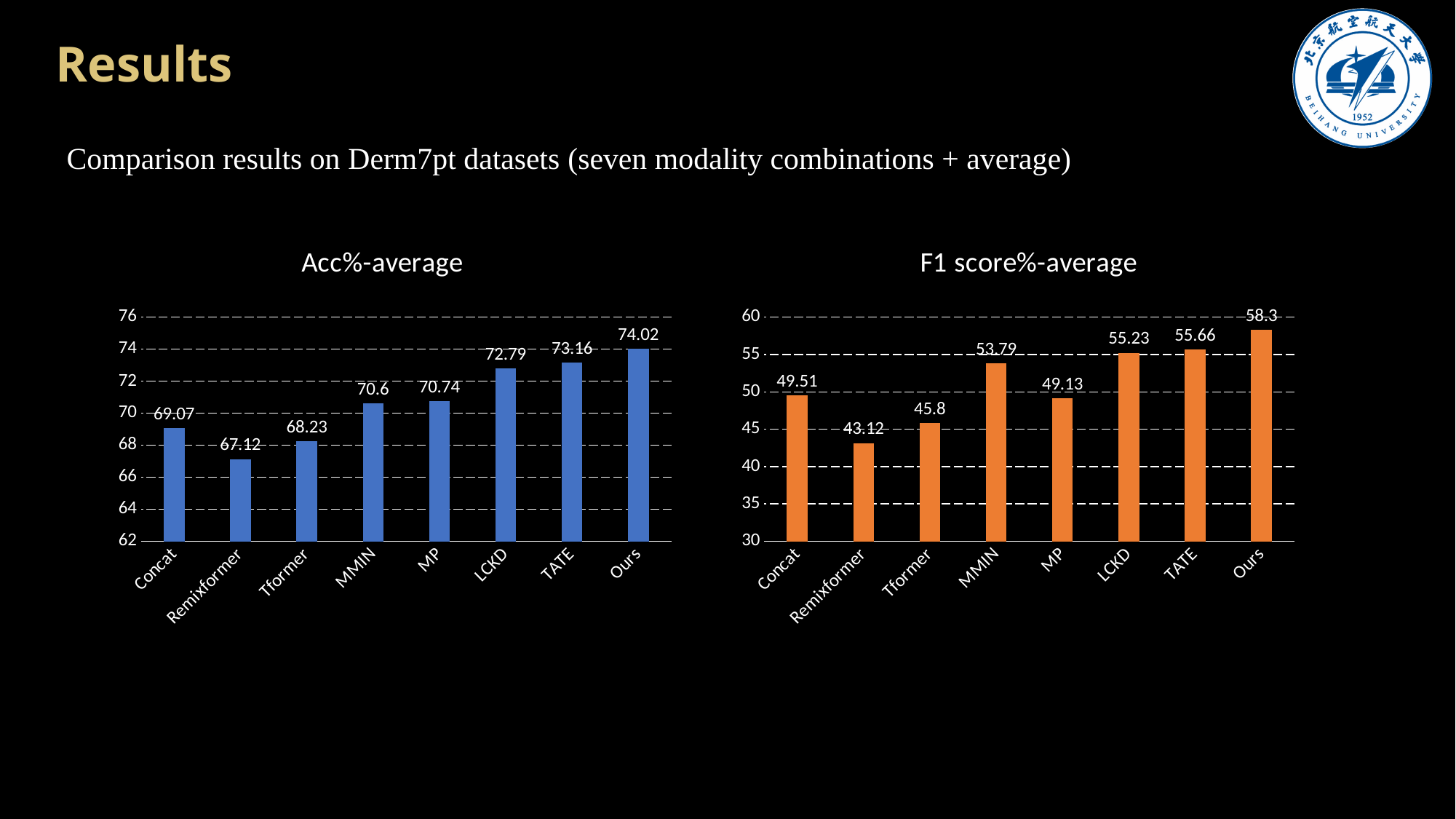
What colour are the bars in the F1 score%-average chart? orange What kind of chart is the F1 score%-average chart? bar chart In the Acc%-average chart, what is the value for Ours? 74.02 In the Acc%-average chart, what is the value for Tformer? 68.23 How many methods are shown in the Acc%-average chart? 8 In the F1 score%-average chart, what is the value for MMIN? 53.79 In the Acc%-average chart, what is the difference between Ours and TATE? 0.86 In the Acc%-average chart, which method has the lowest value? Remixformer In the F1 score%-average chart, what is the difference between Ours and Remixformer? 15.18 In the F1 score%-average chart, which is larger, Concat or MP? Concat In the F1 score%-average chart, which method has the highest value? Ours In the Acc%-average chart, is the value for LCKD greater or less than 72? greater